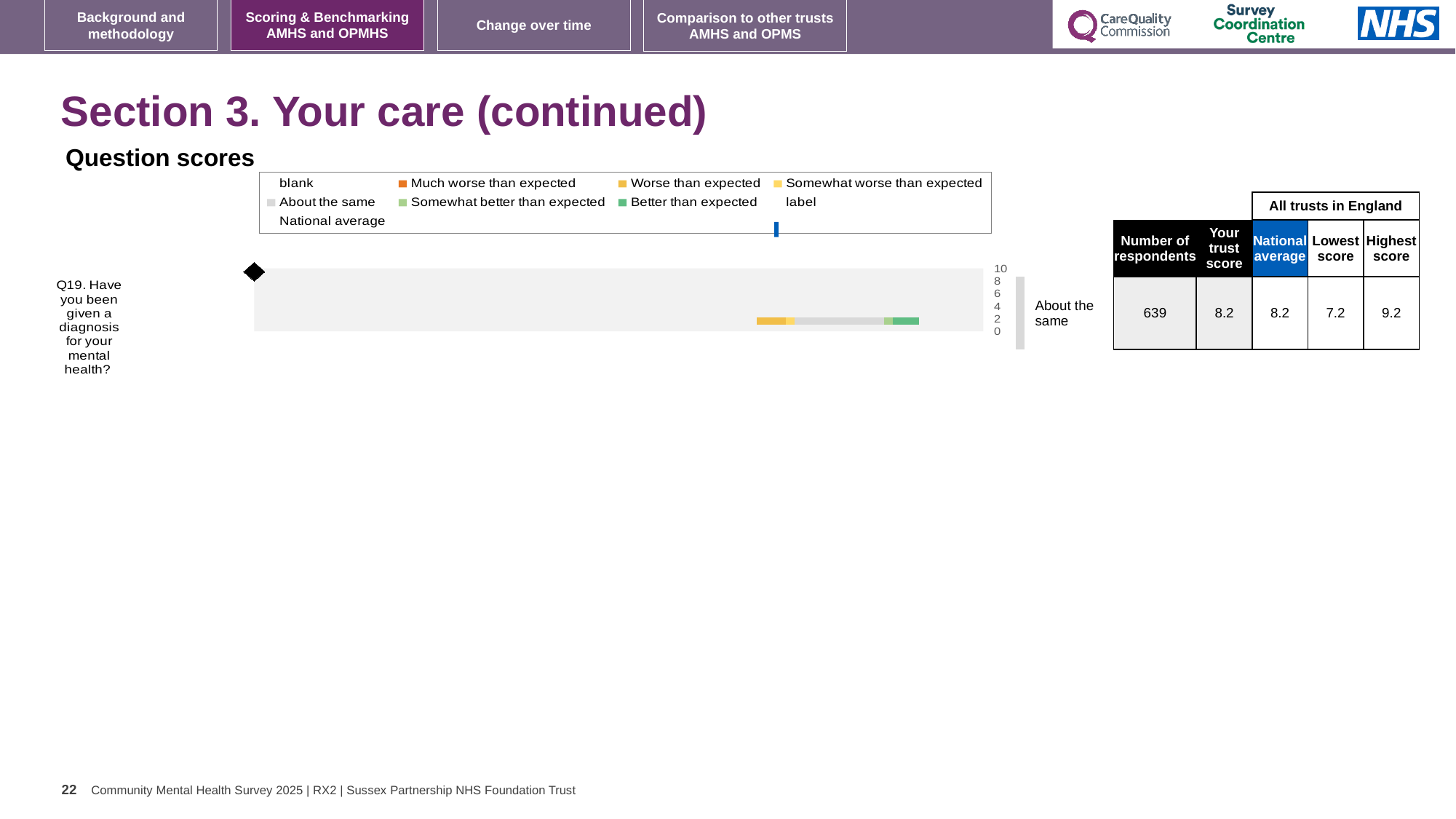
What kind of chart is used to show the Q19 question score? bar chart What is the highest score among all trusts in England for Q19? 9.2 What is the national average score for Q19? 8.2 What is the trust score for Q19 shown in the table beside the chart? 8.2 What is the difference between the highest score and the lowest score for Q19? 2.0 What is the difference between the trust score and the lowest score for Q19? 1.0 How many respondents answered Q19? 639 Which question is plotted on the chart? Q19. Have you been given a diagnosis for your mental health? Is the trust score for Q19 higher than, lower than, or equal to the national average? equal What benchmark rating label is shown to the right of the Q19 bar? About the same What is the lowest score among all trusts in England for Q19? 7.2 How many survey questions are plotted on the chart? 1